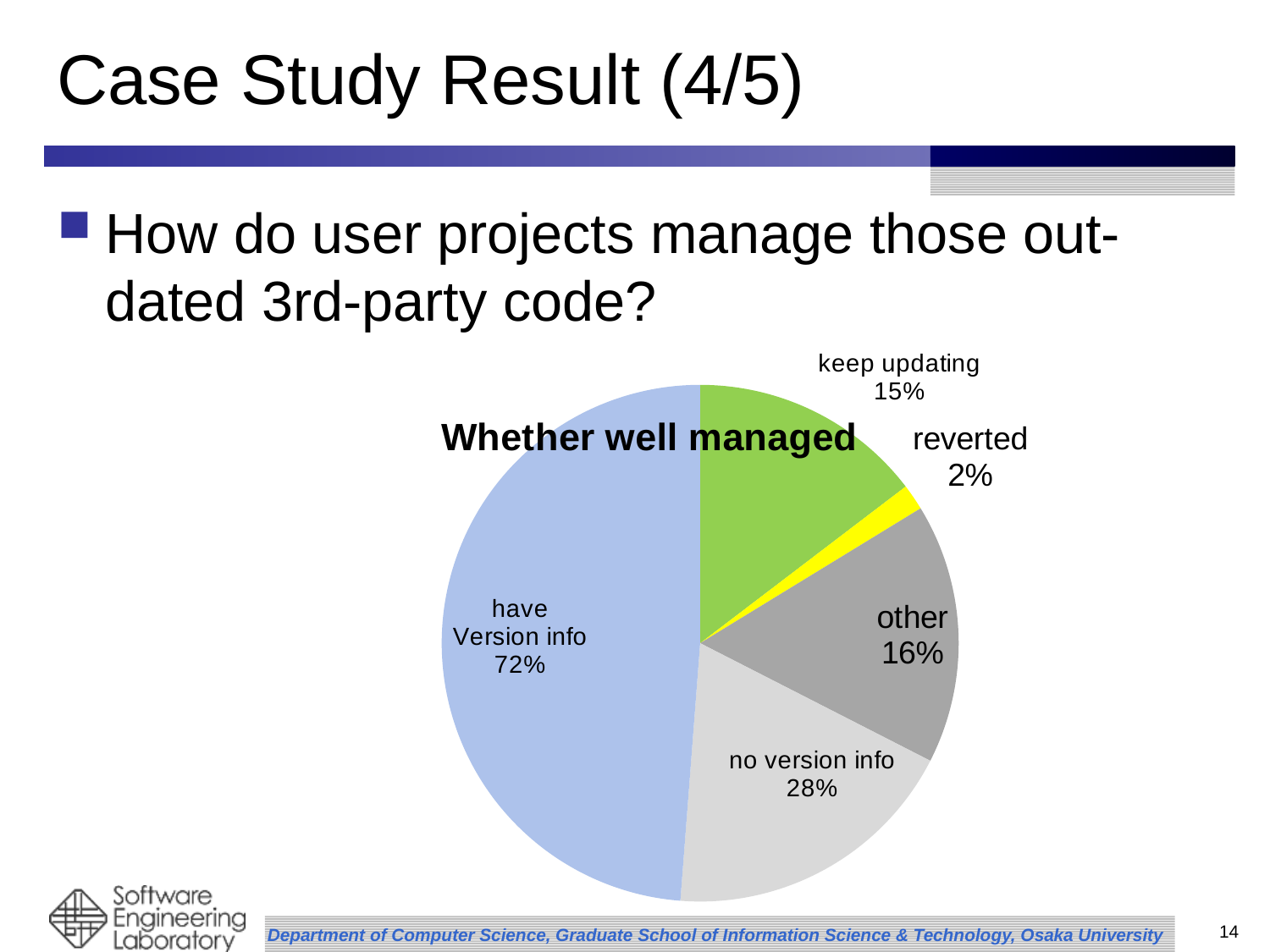
What percentage is shown for the 'have Version info' slice? 72% Which slice is larger, 'keep updating' or 'reverted'? keep updating What percentage is shown for the 'no version info' slice? 28% What percentage is shown for the 'other' slice? 16% What is the difference in percentage points between the 'no version info' slice and the 'other' slice? 12 What percentage is shown for the 'reverted' slice? 2% Which slice of the pie chart has the largest percentage? have Version info Which slice of the pie chart has the smallest percentage? reverted How many slices does the pie chart have? 5 What kind of chart is shown on the slide? pie chart What is the title of the pie chart? Whether well managed What percentage is shown for the 'keep updating' slice? 15%